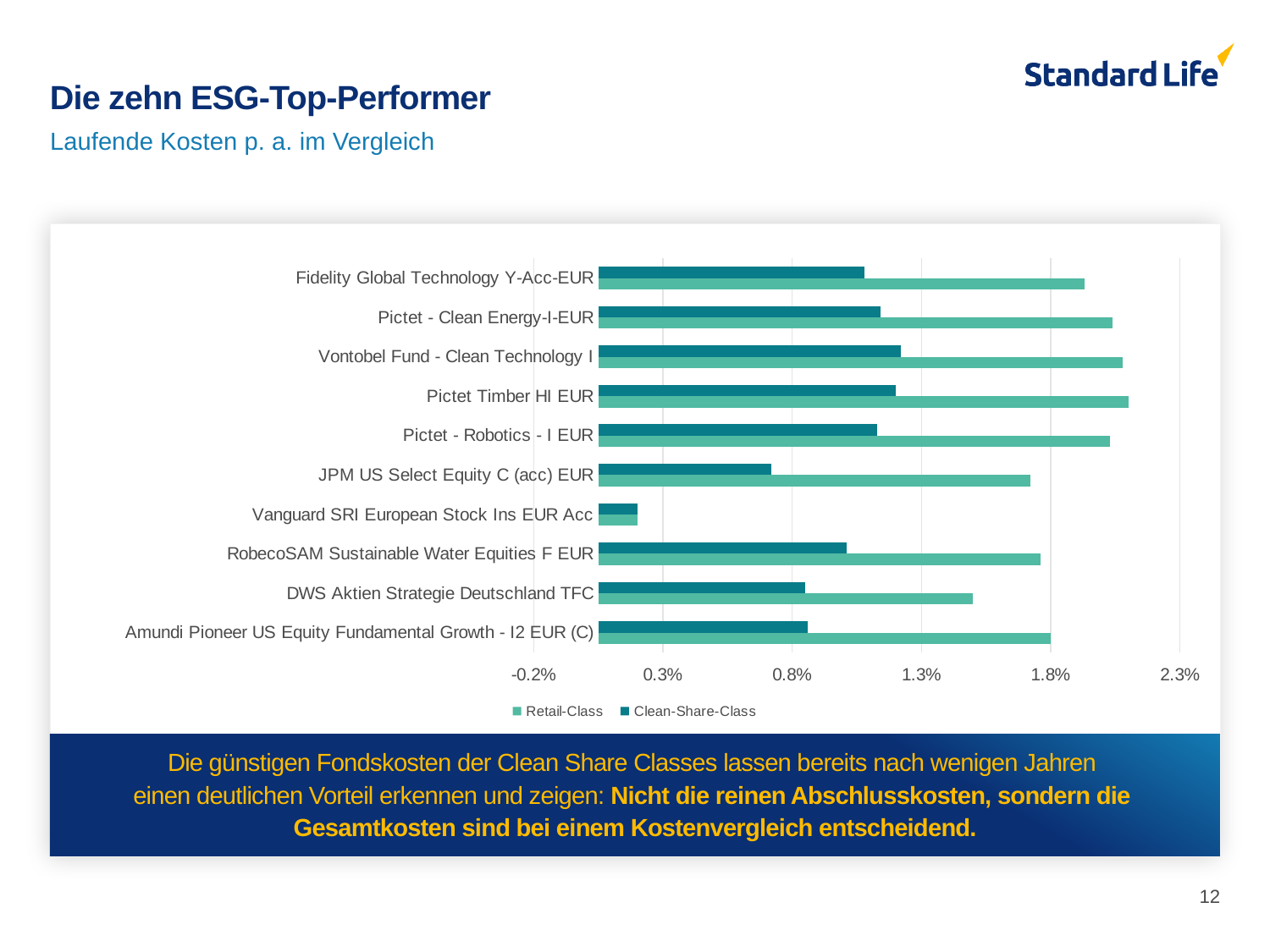
Which two series are shown in the legend? Retail-Class and Clean-Share-Class Is the Retail-Class value for DWS Aktien Strategie Deutschland TFC greater or less than 1.8%? less For Fidelity Global Technology Y-Acc-EUR, which is larger: the Retail-Class value or the Clean-Share-Class value? Retail-Class Which has the larger Retail-Class value: DWS Aktien Strategie Deutschland TFC or Amundi Pioneer US Equity Fundamental Growth - I2 EUR (C)? Amundi Pioneer US Equity Fundamental Growth - I2 EUR (C) Is the Clean-Share-Class value for Vanguard SRI European Stock Ins EUR Acc greater or less than 0.3%? less Which fund has the lowest Clean-Share-Class value? Vanguard SRI European Stock Ins EUR Acc How many funds are listed on the chart? 10 Which fund has the lowest Retail-Class value? Vanguard SRI European Stock Ins EUR Acc How many series does the legend list? 2 Is the Retail-Class value for Fidelity Global Technology Y-Acc-EUR greater or less than 1.8%? greater What is the subtitle of the chart slide? Laufende Kosten p. a. im Vergleich What kind of chart is shown on the slide? Bar chart